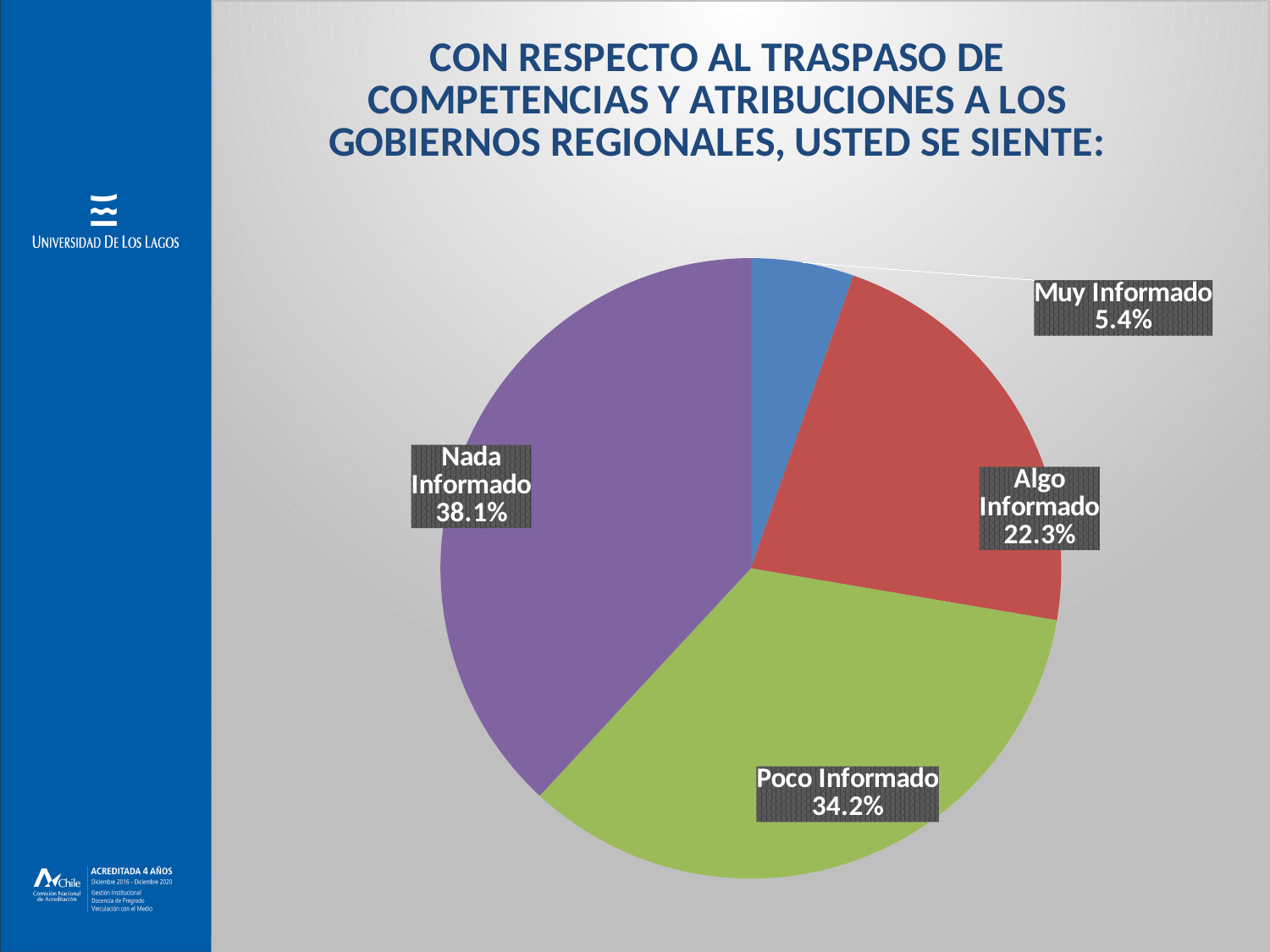
What is the difference in percentage points between "Nada Informado" and "Poco Informado"? 3.9 What percentage of respondents answered "Muy Informado"? 5.4% Which category has the smallest share of the pie? Muy Informado What percentage of respondents answered "Algo Informado"? 22.3% What colour is the "Nada Informado" slice? Purple What kind of chart is shown on the slide? Pie chart What percentage of respondents answered "Nada Informado"? 38.1% How many categories (slices) does the pie chart have? 4 Which category has the largest share of the pie? Nada Informado Which is larger, the share for "Algo Informado" or the share for "Poco Informado"? Poco Informado What is the difference in percentage points between "Algo Informado" and "Muy Informado"? 16.9 What percentage of respondents answered "Poco Informado"? 34.2%